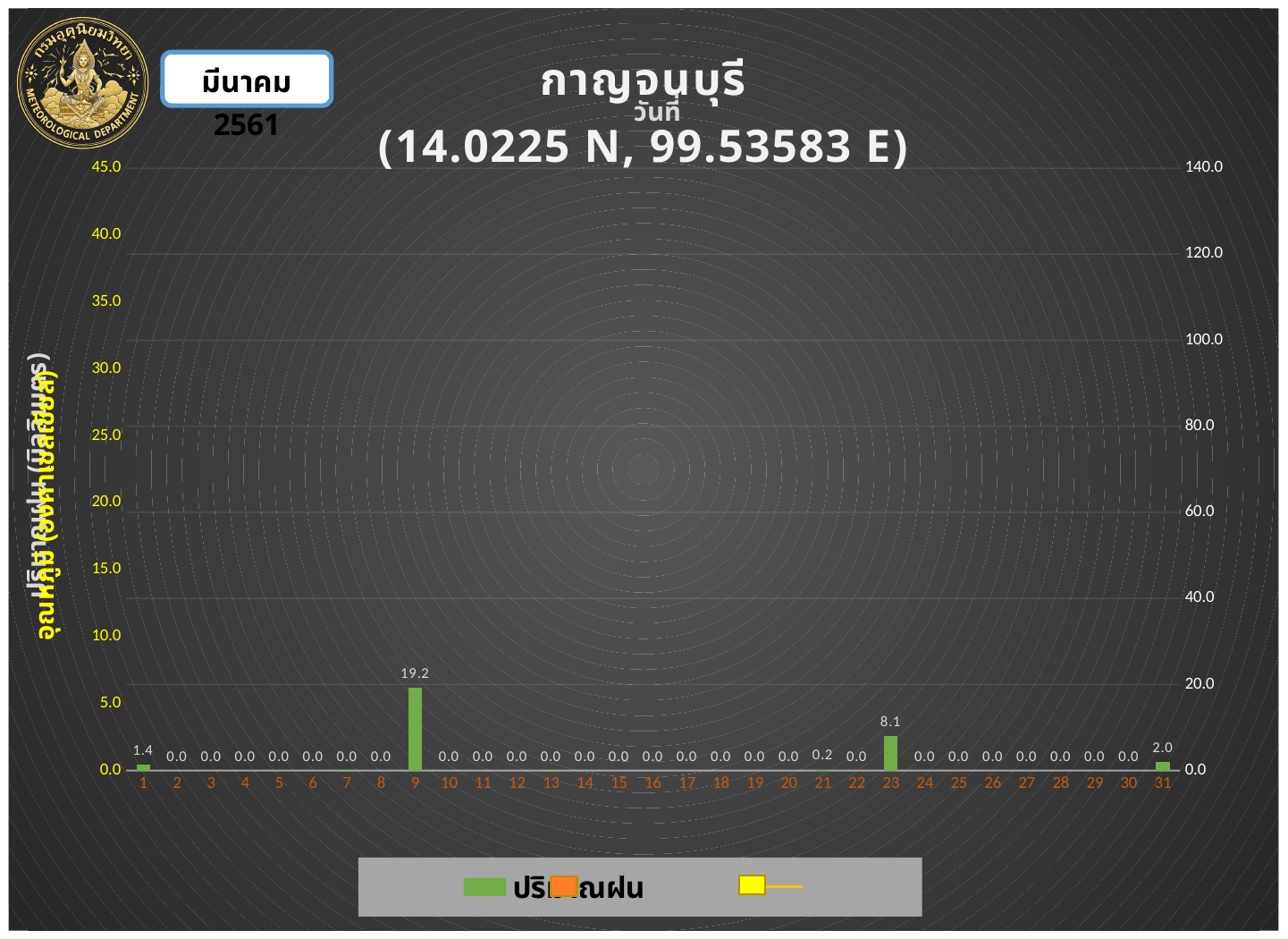
Which day has the highest rainfall value? 9 What is the rainfall value shown for day 21? 0.2 What is the rainfall value shown for day 9? 19.2 Which has the larger rainfall value, day 23 or day 31? day 23 What is the rainfall value shown for day 31? 2.0 What kind of chart is shown on the slide? bar chart What is the difference between the rainfall values for day 9 and day 23? 11.1 How many days are shown on the x axis? 31 What is the rainfall value shown for day 23? 8.1 What is the rainfall value shown for day 1? 1.4 What coordinates are given in the chart title? 14.0225 N, 99.53583 E What is the rainfall value shown for day 15? 0.0